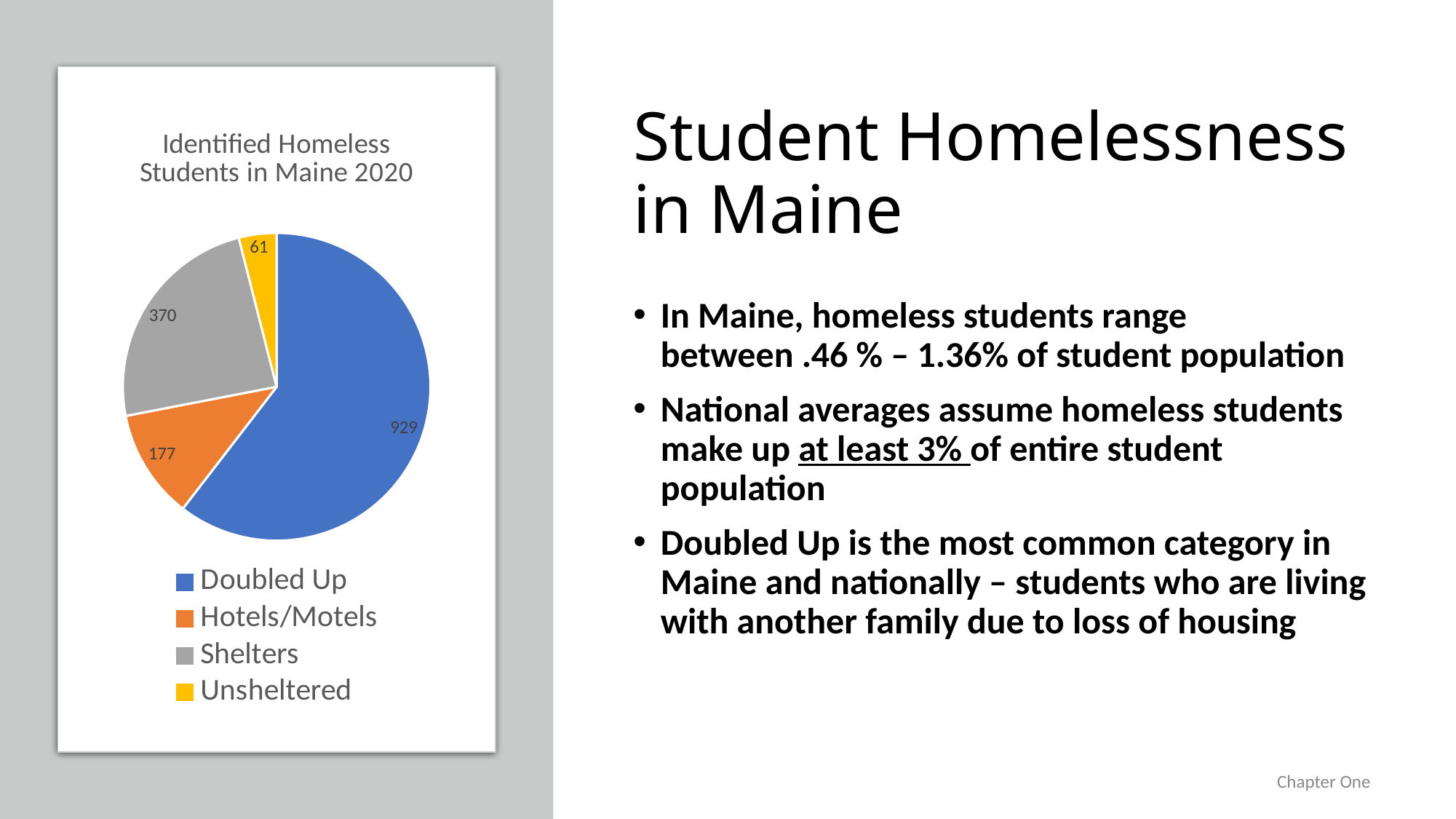
What is the value for Doubled Up? 929 Which is larger, Shelters or Hotels/Motels? Shelters What is the difference between the Doubled Up and Shelters values? 559 What type of chart is shown on the slide? Pie chart What is the value for Unsheltered? 61 What is the title of the chart? Identified Homeless Students in Maine 2020 What is the value for Hotels/Motels? 177 What colour is the Unsheltered slice? Yellow Which category has the smallest slice? Unsheltered How many categories does the pie chart show? 4 What is the value for Shelters? 370 Which category has the largest slice? Doubled Up